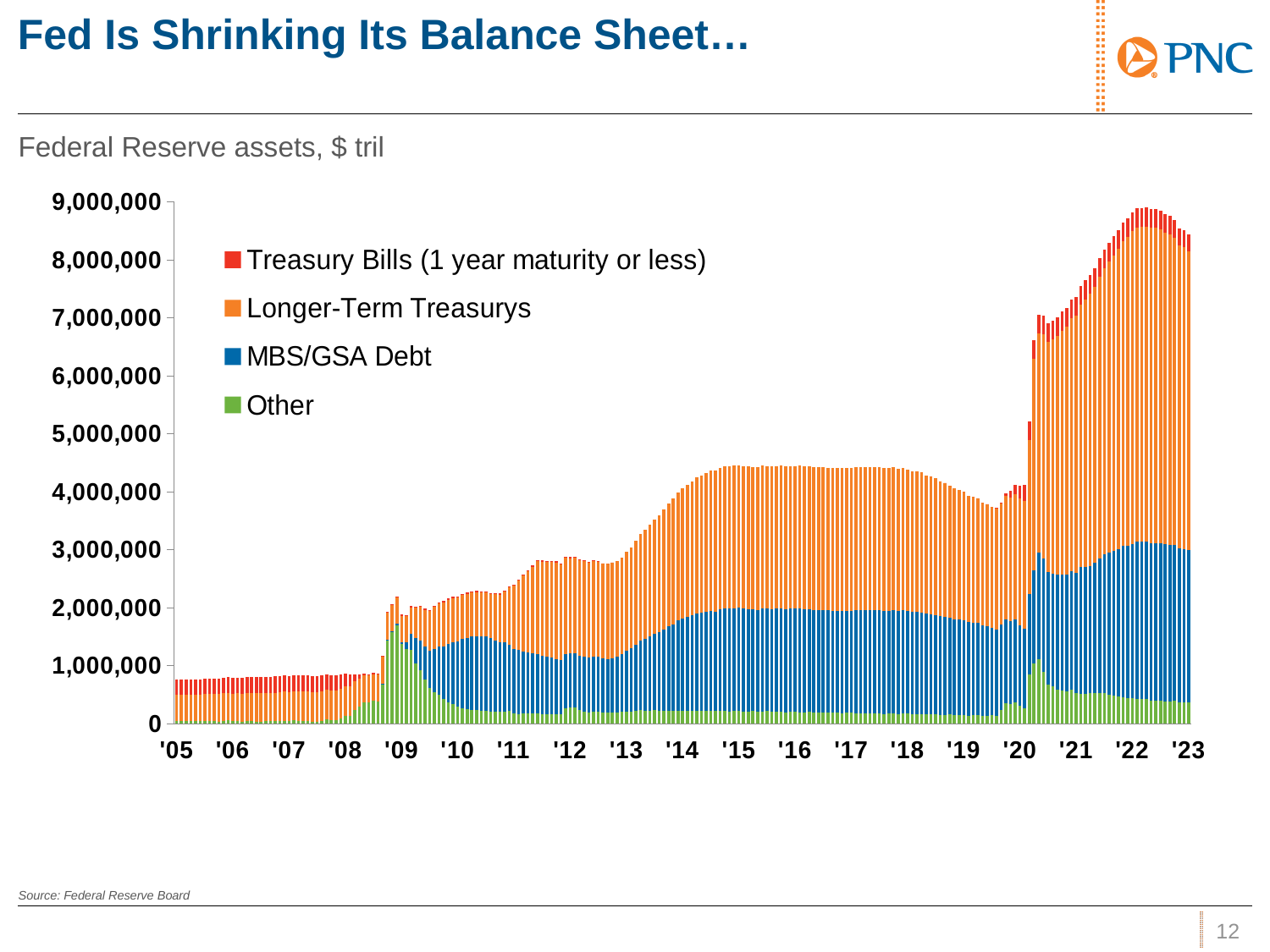
Which series is shown in green in the legend? Other What kind of chart is shown on the slide? Stacked bar chart What is the subtitle describing the chart's data? Federal Reserve assets, $ tril Is the total value of the bar at '05 greater or less than 1,000,000? less Is the total value of the bar at '22 greater or less than 8,000,000? greater How many year labels are shown on the x axis? 19 Around which year label do the stacked bars reach their highest total? '22 How many series does the legend list? 4 Which has the larger total, the bar at '16 or the bar at '10? '16 Do the total values rise or fall from '22 to '23? fall Is the total value of the bar at '10 greater or less than 2,000,000? greater